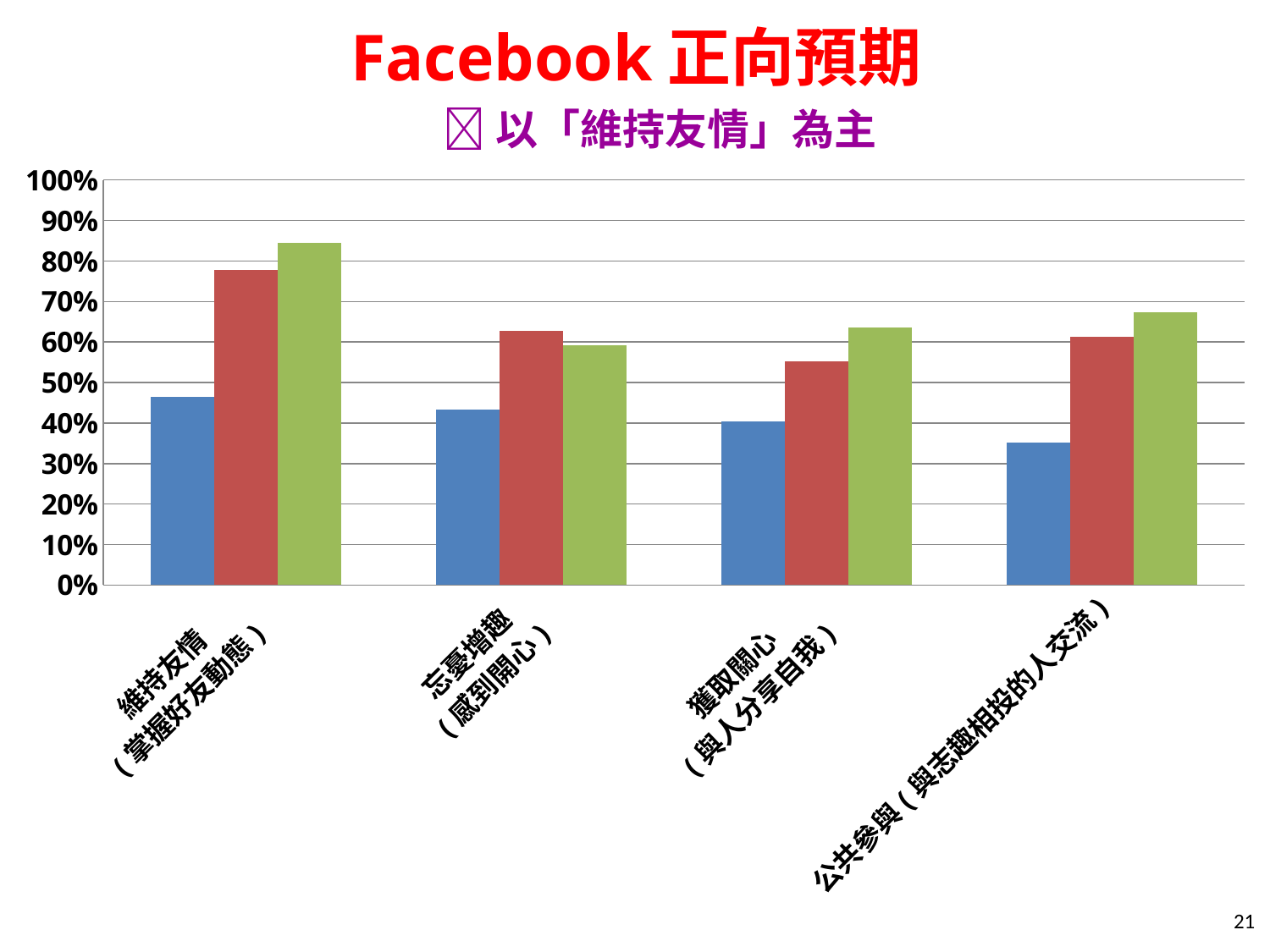
Do the blue bars rise or fall moving from left to right across the categories? fall How many categories are shown along the x axis of the chart? 4 Is the value of the blue bar for 公共參與（與志趣相投的人交流） greater or less than 40%? less Is the value of the blue bar for 維持友情（掌握好友動態） greater or less than 50%? less What kind of chart is shown on the slide? bar chart Is the value of the green bar for 維持友情（掌握好友動態） greater or less than 80%? greater Which category has the tallest bar in the chart? 維持友情（掌握好友動態） How many bars are plotted for each category in the chart? 3 For 忘憂增趣（感到開心）, which bar is taller: the red bar or the green bar? the red bar What is the main title of the slide above the chart? Facebook 正向預期 Which category has the shortest bar in the chart? 公共參與（與志趣相投的人交流）